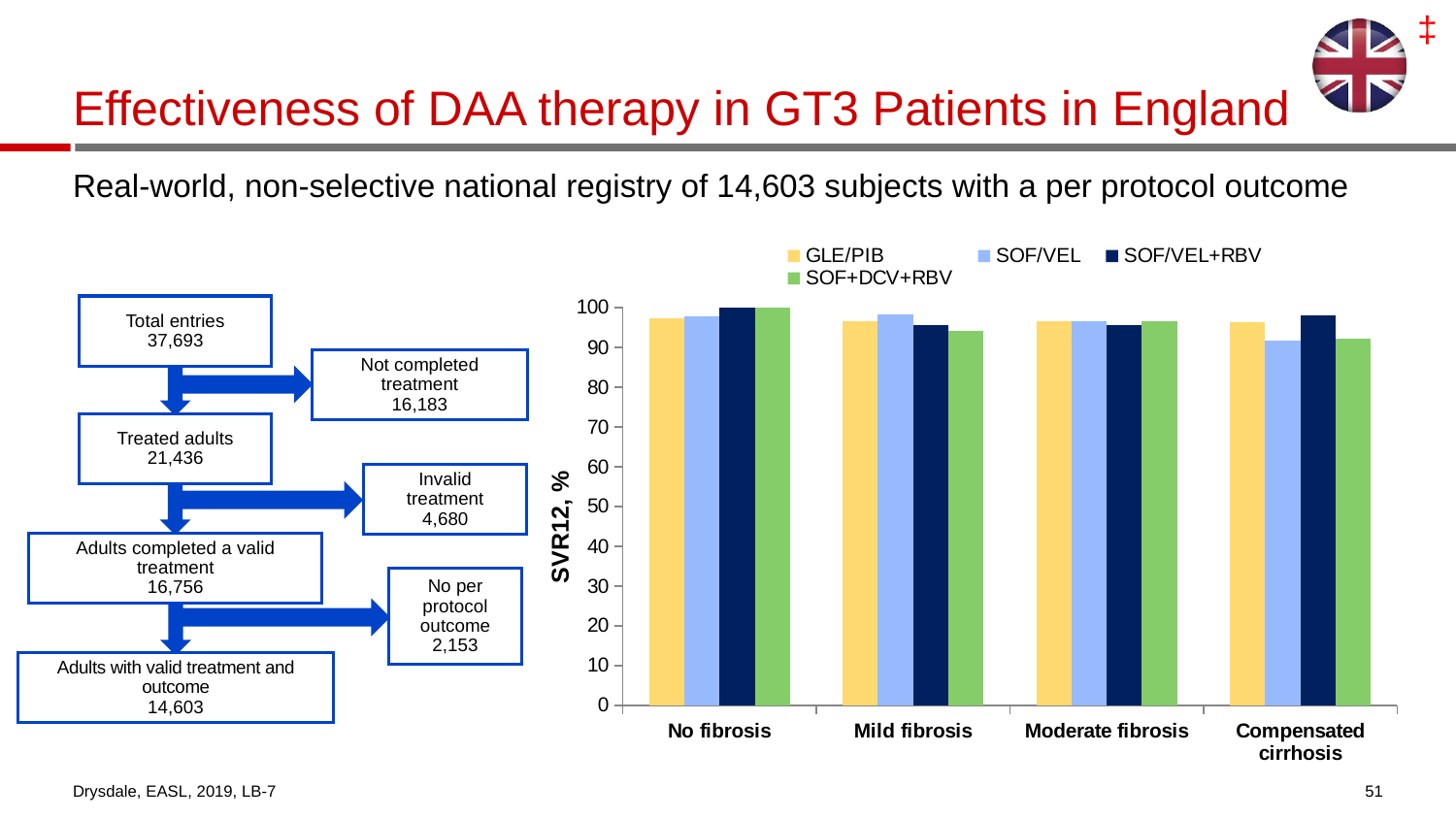
In the Compensated cirrhosis group, which has the higher SVR12: GLE/PIB or SOF/VEL? GLE/PIB Is the SVR12 value for SOF/VEL+RBV in the Compensated cirrhosis group greater or less than 90? greater Is the SVR12 value for SOF+DCV+RBV in the Mild fibrosis group greater or less than 80? greater In the Mild fibrosis group, which has the higher SVR12: SOF/VEL or SOF+DCV+RBV? SOF/VEL In the Compensated cirrhosis group, which series has the highest SVR12? SOF/VEL+RBV What is the label of the y axis of the chart? SVR12, % In the Mild fibrosis group, which series has the highest SVR12? SOF/VEL Which series is shown in dark navy blue in the chart? SOF/VEL+RBV What type of chart is shown on the slide? Bar chart How many fibrosis categories are shown on the x axis of the chart? 4 How many series does the chart legend list? 4 Is the SVR12 value for GLE/PIB in the No fibrosis group greater or less than 90? greater